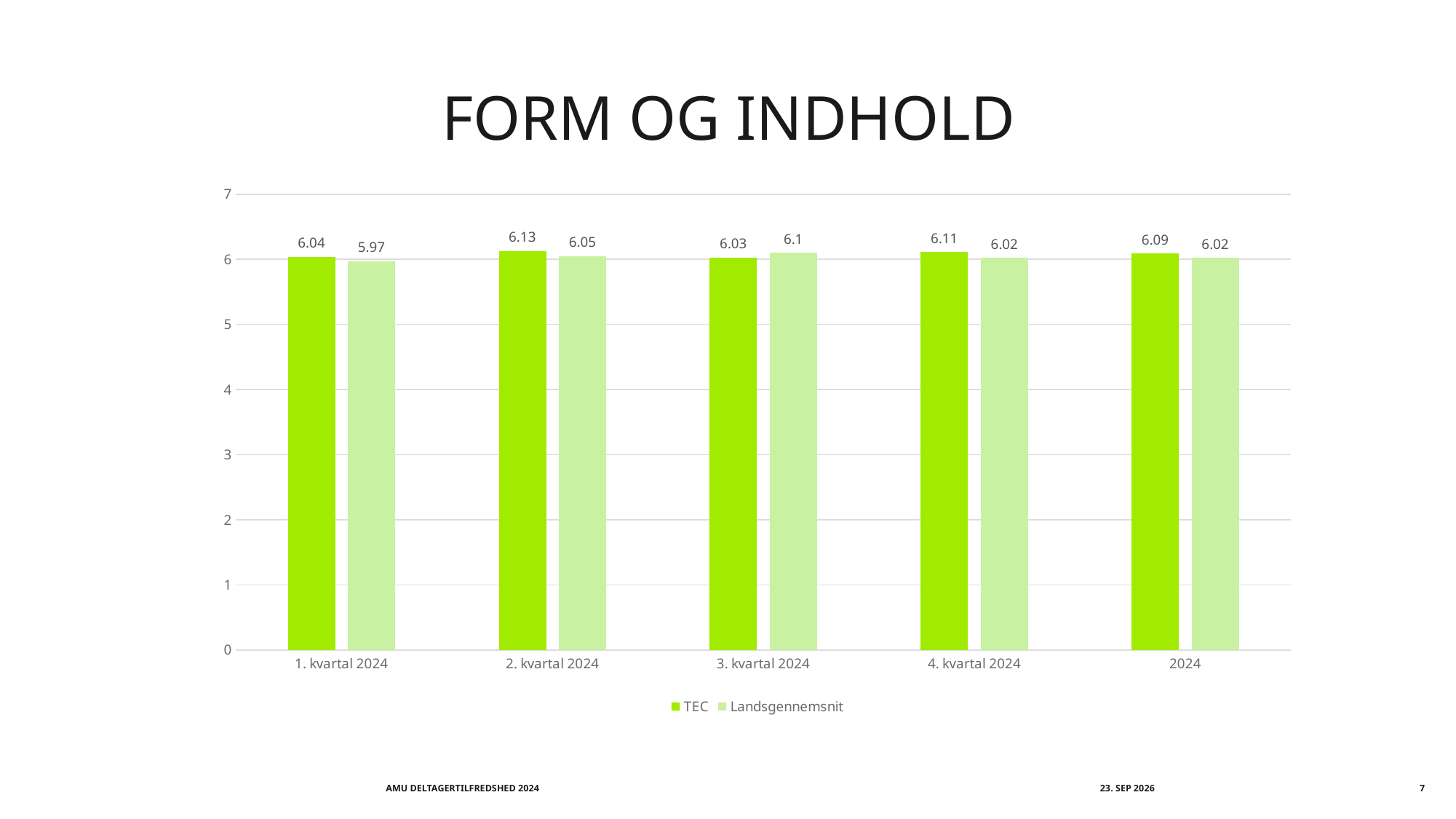
Which category has the highest TEC value? 2. kvartal 2024 How many series does the legend list? 2 What kind of chart is shown on the slide? bar chart What is the Landsgennemsnit value for 3. kvartal 2024? 6.1 Which category has the lowest Landsgennemsnit value? 1. kvartal 2024 What is the title of the slide? FORM OG INDHOLD For 3. kvartal 2024, which is larger: TEC or Landsgennemsnit? Landsgennemsnit What is the TEC value for 1. kvartal 2024? 6.04 How many categories are shown on the x axis? 5 What is the difference between the TEC and Landsgennemsnit values for 4. kvartal 2024? 0.09 What is the TEC value for 2024? 6.09 Is the Landsgennemsnit value for 1. kvartal 2024 greater or less than 6? less